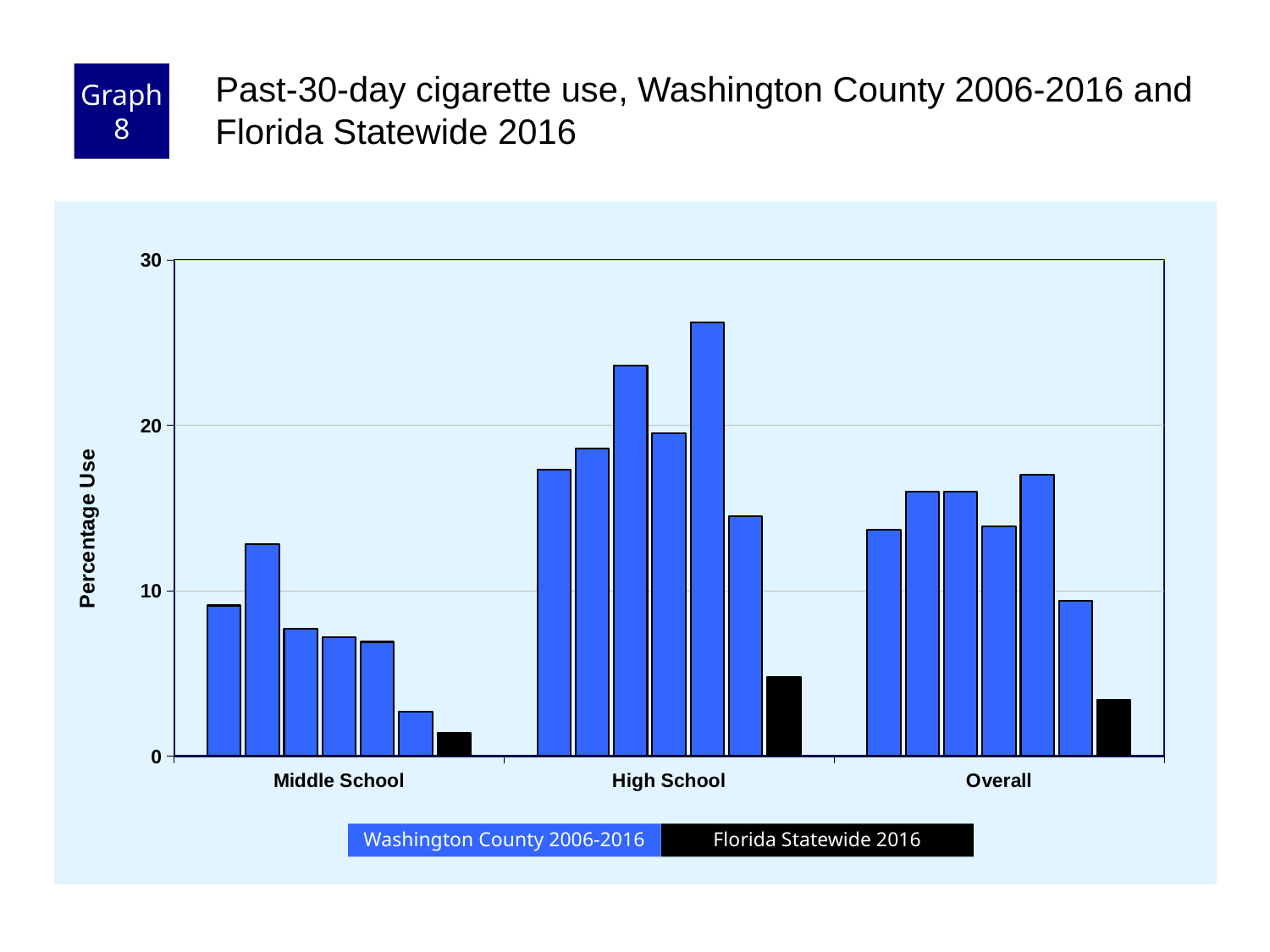
Is the tallest Washington County 2006-2016 bar in the Middle School group greater or less than 20? less Is the Florida Statewide 2016 value for High School greater or less than 10? less Is the tallest Washington County 2006-2016 bar in the High School group greater or less than 20? greater Which category group contains the tallest bar on the chart? High School What colour are the Florida Statewide 2016 bars? black Which is larger, the Florida Statewide 2016 value for High School or for Middle School? High School What kind of chart is shown on the slide? bar chart How many category groups are shown on the x axis? 3 What is the title of the y axis? Percentage Use How many series does the legend list? 2